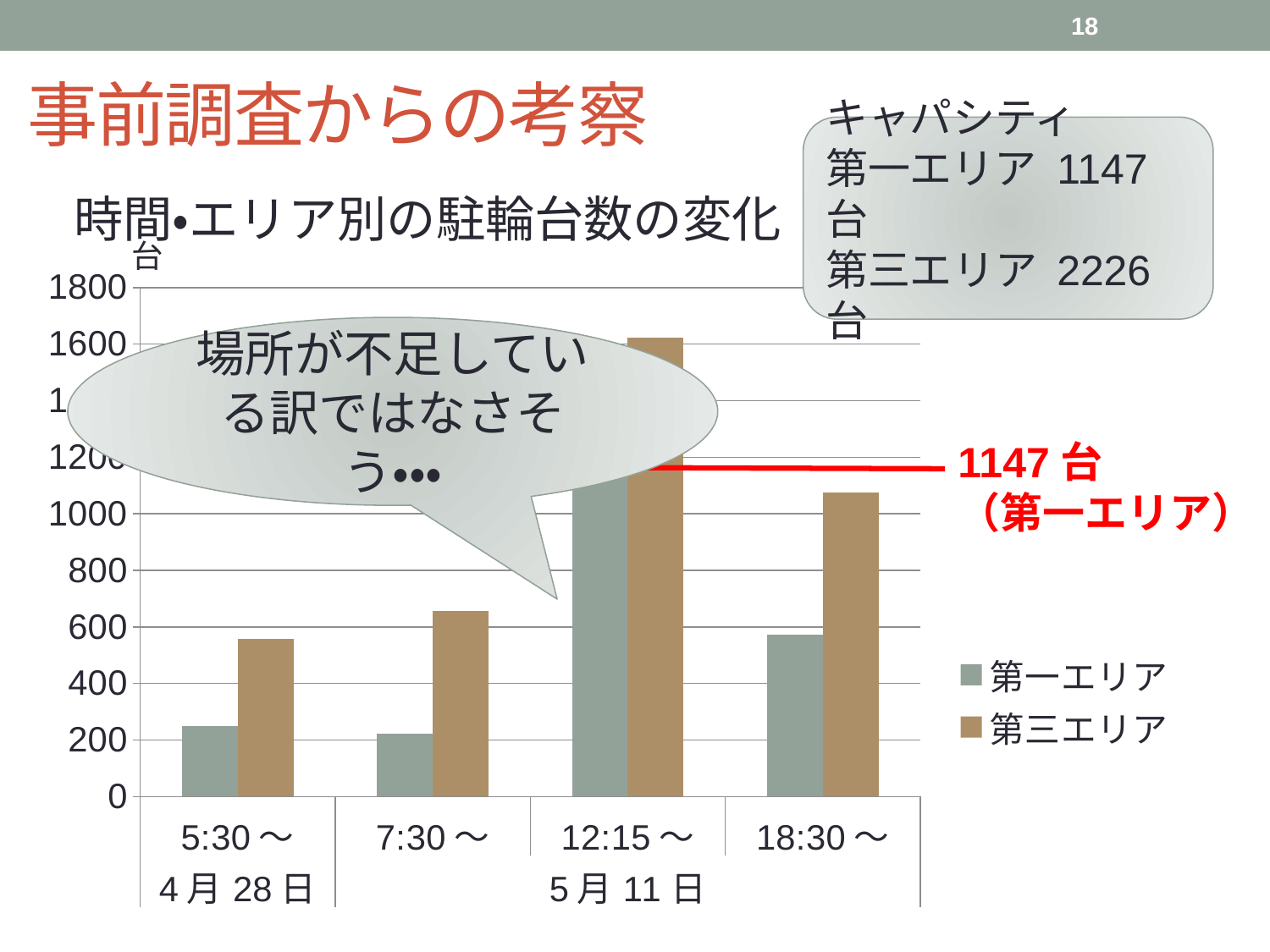
Is the value for 第三エリア at 18:30～ greater or less than 1000? greater At which time is the value for 第三エリア highest? 12:15～ What is the title of the chart? 時間•エリア別の駐輪台数の変化 Which series are listed in the chart legend? 第一エリア, 第三エリア What kind of chart is shown on the slide? bar chart Is the value for 第一エリア at 5:30～ greater or less than 400? less Does the value for 第三エリア rise or fall from 5:30～ to 12:15～? rise At 7:30～, which series has the larger value, 第一エリア or 第三エリア? 第三エリア How many time categories are shown on the x axis of the chart? 4 At which time is the value for 第一エリア highest? 12:15～ How many series does the chart legend list? 2 At which time is the value for 第三エリア lowest? 5:30～